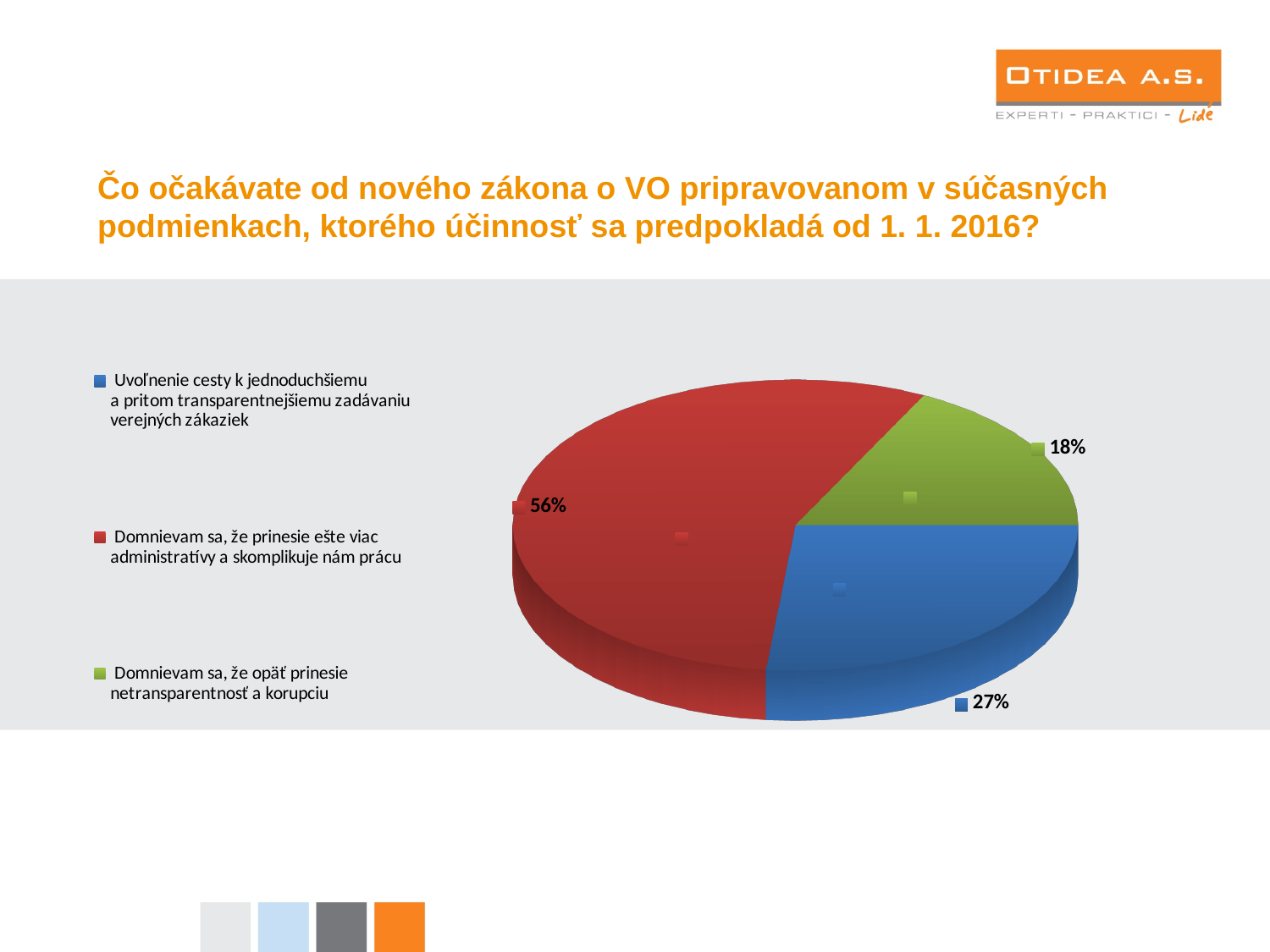
How many slices does the pie chart have? 3 Which is larger: the share for "Uvoľnenie cesty k jednoduchšiemu a pritom transparentnejšiemu zadávaniu verejných zákaziek" or the share for "Domnievam sa, že opäť prinesie netransparentnosť a korupciu"? Uvoľnenie cesty k jednoduchšiemu a pritom transparentnejšiemu zadávaniu verejných zákaziek Which answer has the largest share of the pie? Domnievam sa, že prinesie ešte viac administratívy a skomplikuje nám prácu What share of respondents answered "Uvoľnenie cesty k jednoduchšiemu a pritom transparentnejšiemu zadávaniu verejných zákaziek"? 27% What share of respondents answered "Domnievam sa, že prinesie ešte viac administratívy a skomplikuje nám prácu"? 56% Which answer has the smallest share of the pie? Domnievam sa, že opäť prinesie netransparentnosť a korupciu What kind of chart is shown on the slide? pie chart What colour is the slice labelled 18%? green What colour is the slice representing "Domnievam sa, že prinesie ešte viac administratívy a skomplikuje nám prácu"? red What is the difference in percentage points between the 27% slice and the 18% slice? 9 What is the difference in percentage points between the largest slice (56%) and the smallest slice (18%)? 38 What share of respondents answered "Domnievam sa, že opäť prinesie netransparentnosť a korupciu"? 18%